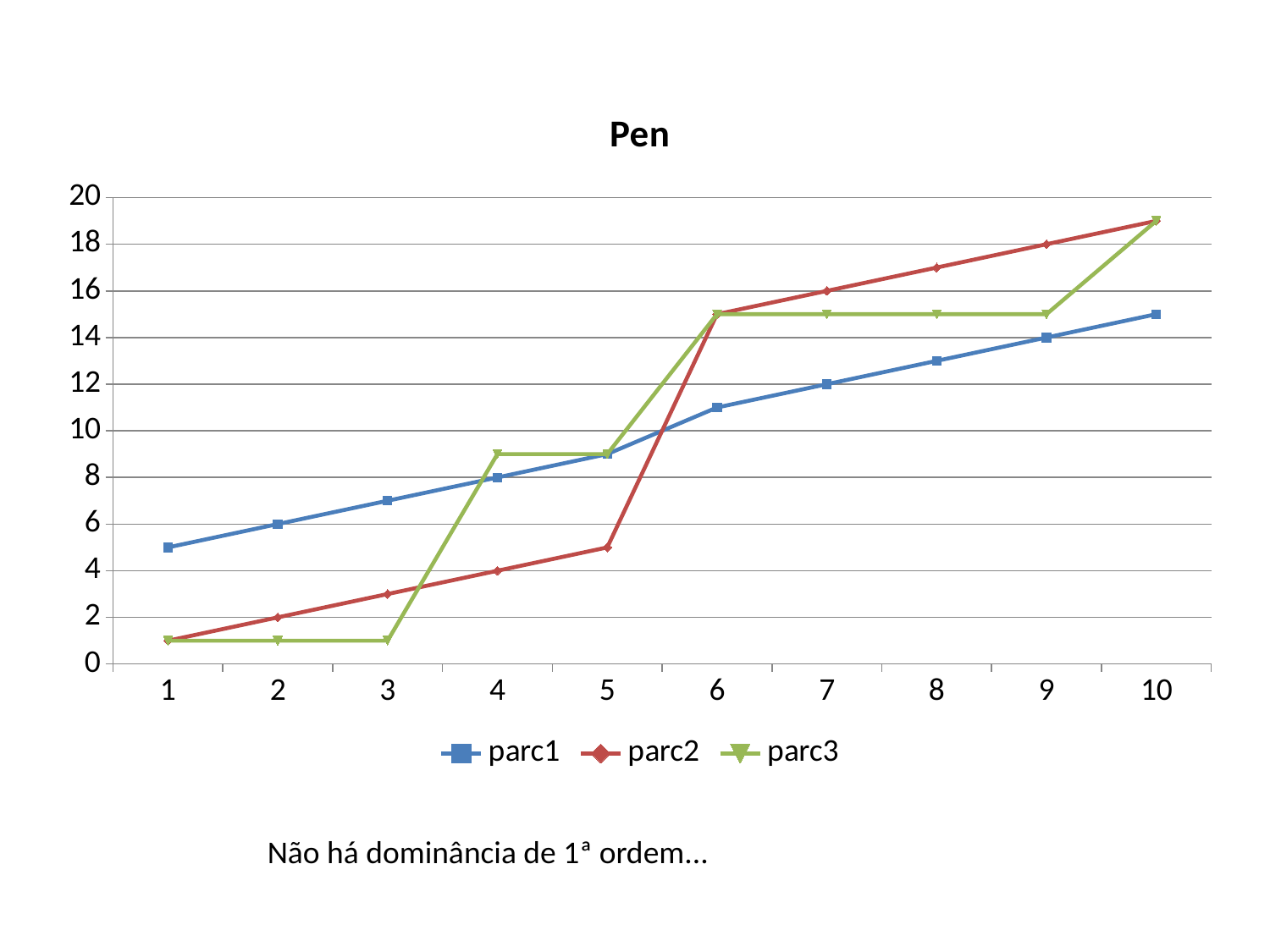
How many series does the legend list? 3 How many points are plotted along the x axis for each series? 10 What is the title of the chart? Pen What is the value of parc1 at x = 7? 12 At x = 10, which series has the higher value, parc1 or parc2? parc2 What is the value of parc1 at x = 4? 8 What kind of chart is shown on the slide? line chart Which series has the highest value at x = 1? parc1 Is the value of parc3 at x = 2 greater or less than 2? less Do the values of parc1 rise or fall as x increases from 1 to 10? rise Is the value of parc2 at x = 10 greater or less than 18? greater What is the value of parc2 at x = 9? 18